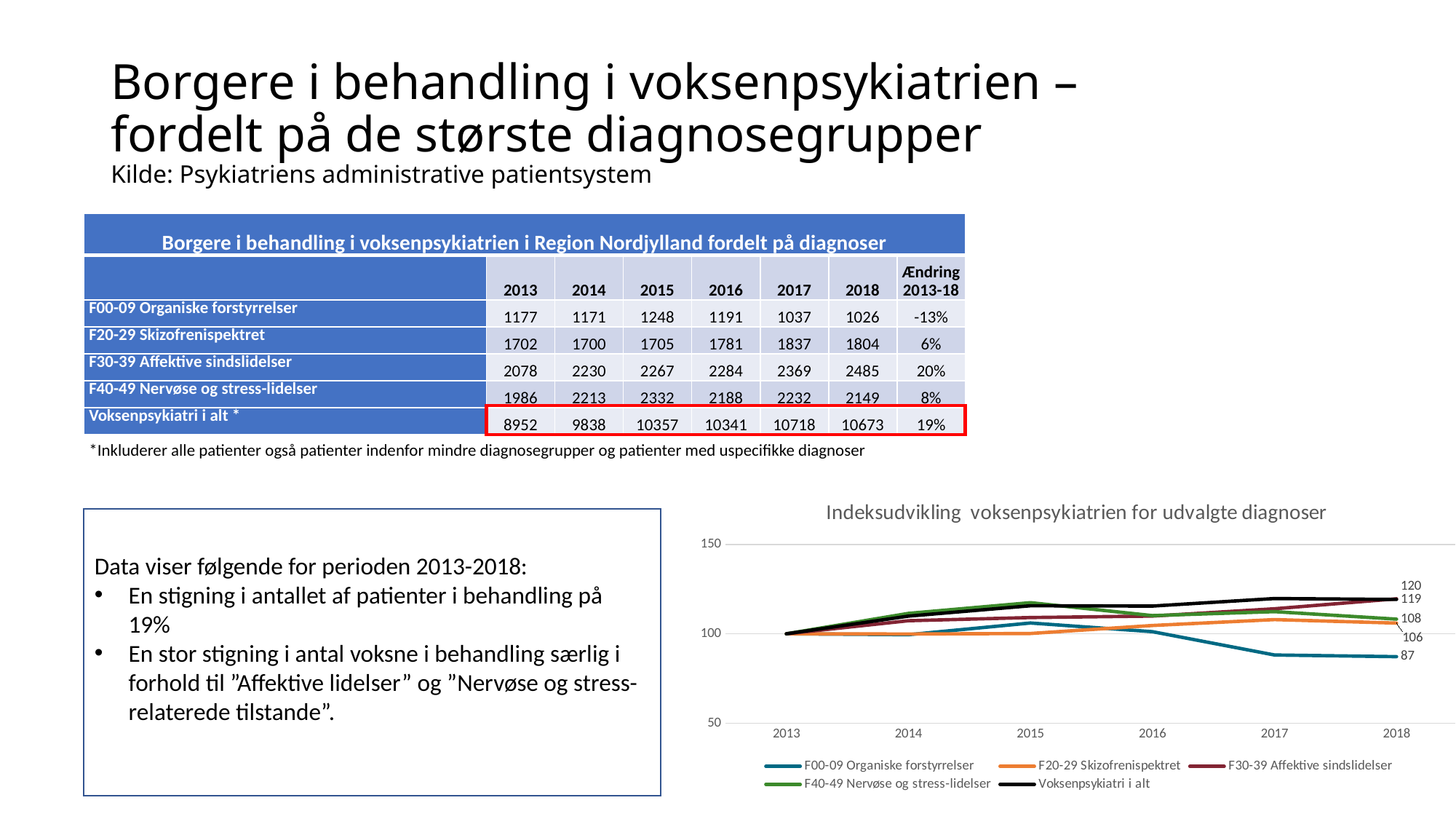
In the chart "Indeksudvikling voksenpsykiatrien for udvalgte diagnoser", what is the index value for F20-29 Skizofrenispektret in 2018? 106 What is the title of the line chart on the slide? Indeksudvikling voksenpsykiatrien for udvalgte diagnoser In the chart "Indeksudvikling voksenpsykiatrien for udvalgte diagnoser", what is the index value for F00-09 Organiske forstyrrelser in 2018? 87 What kind of chart is "Indeksudvikling voksenpsykiatrien for udvalgte diagnoser"? line chart How many series does the legend of the chart "Indeksudvikling voksenpsykiatrien for udvalgte diagnoser" list? 5 In the chart "Indeksudvikling voksenpsykiatrien for udvalgte diagnoser", what is the difference between the 2018 values for F40-49 Nervøse og stress-lidelser and F00-09 Organiske forstyrrelser? 21 In the chart "Indeksudvikling voksenpsykiatrien for udvalgte diagnoser", which series has the lowest value in 2018? F00-09 Organiske forstyrrelser In the chart "Indeksudvikling voksenpsykiatrien for udvalgte diagnoser", is the 2018 value for F00-09 Organiske forstyrrelser greater or less than 100? less In the chart "Indeksudvikling voksenpsykiatrien for udvalgte diagnoser", which is larger in 2018: F40-49 Nervøse og stress-lidelser or F20-29 Skizofrenispektret? F40-49 Nervøse og stress-lidelser In the chart "Indeksudvikling voksenpsykiatrien for udvalgte diagnoser", does the F00-09 Organiske forstyrrelser line rise or fall from 2015 to 2018? fall How many years are shown on the x axis of the chart "Indeksudvikling voksenpsykiatrien for udvalgte diagnoser"? 6 In the chart "Indeksudvikling voksenpsykiatrien for udvalgte diagnoser", what is the index value for F40-49 Nervøse og stress-lidelser in 2018? 108